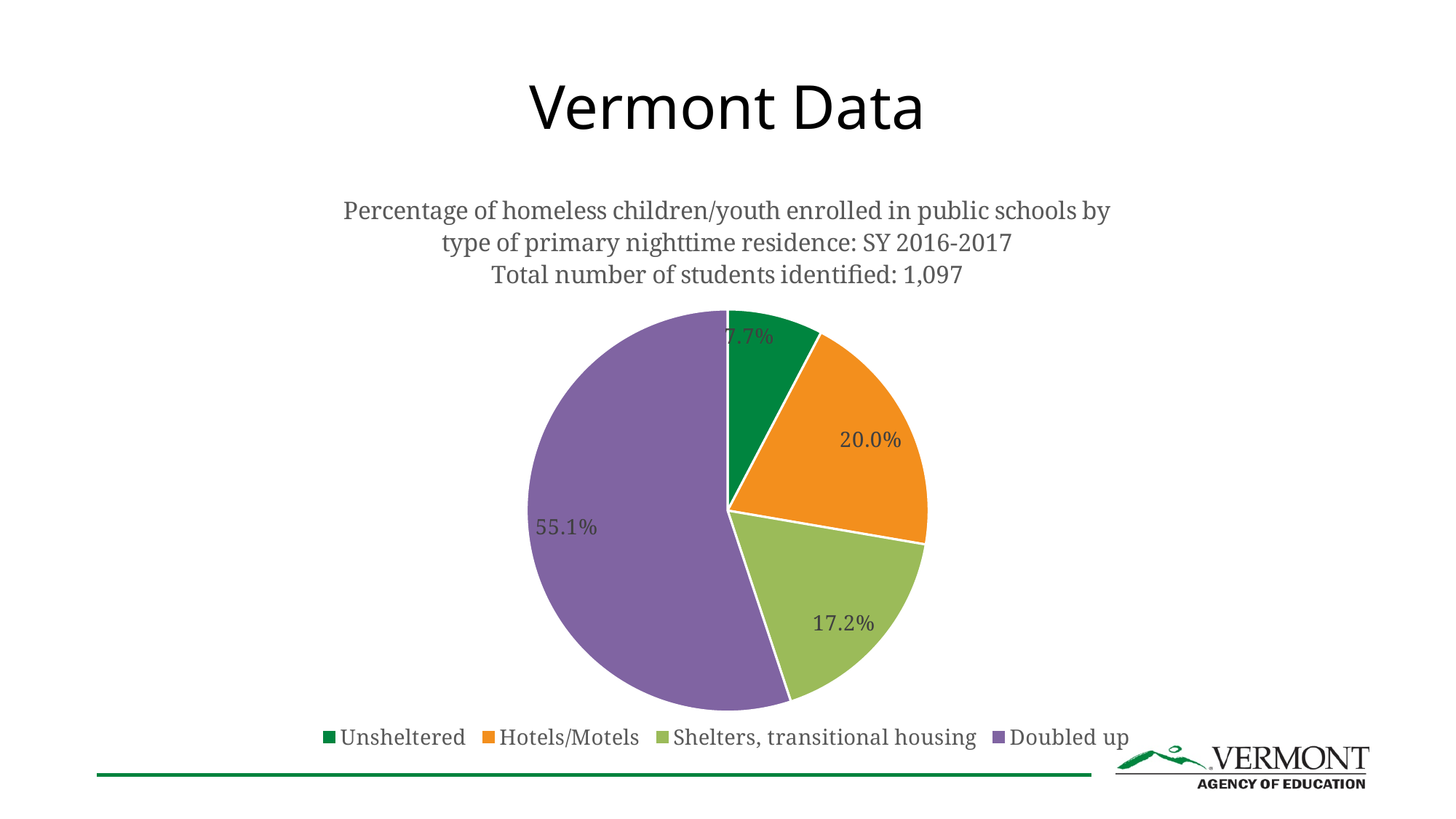
What percentage of homeless children/youth were Unsheltered? 7.7% What percentage of homeless children/youth were in Shelters, transitional housing? 17.2% What is the difference in percentage points between Doubled up and Hotels/Motels? 35.1 What is the total number of students identified, according to the chart title? 1,097 What percentage of homeless children/youth were in Hotels/Motels? 20.0% Which is larger, the share for Hotels/Motels or the share for Shelters, transitional housing? Hotels/Motels How many categories does the pie chart show? 4 Which colour represents the Doubled up slice? Purple What type of chart is shown on the slide? Pie chart What percentage of homeless children/youth were Doubled up? 55.1% Which type of primary nighttime residence has the largest share of the pie? Doubled up Which type of primary nighttime residence has the smallest share of the pie? Unsheltered